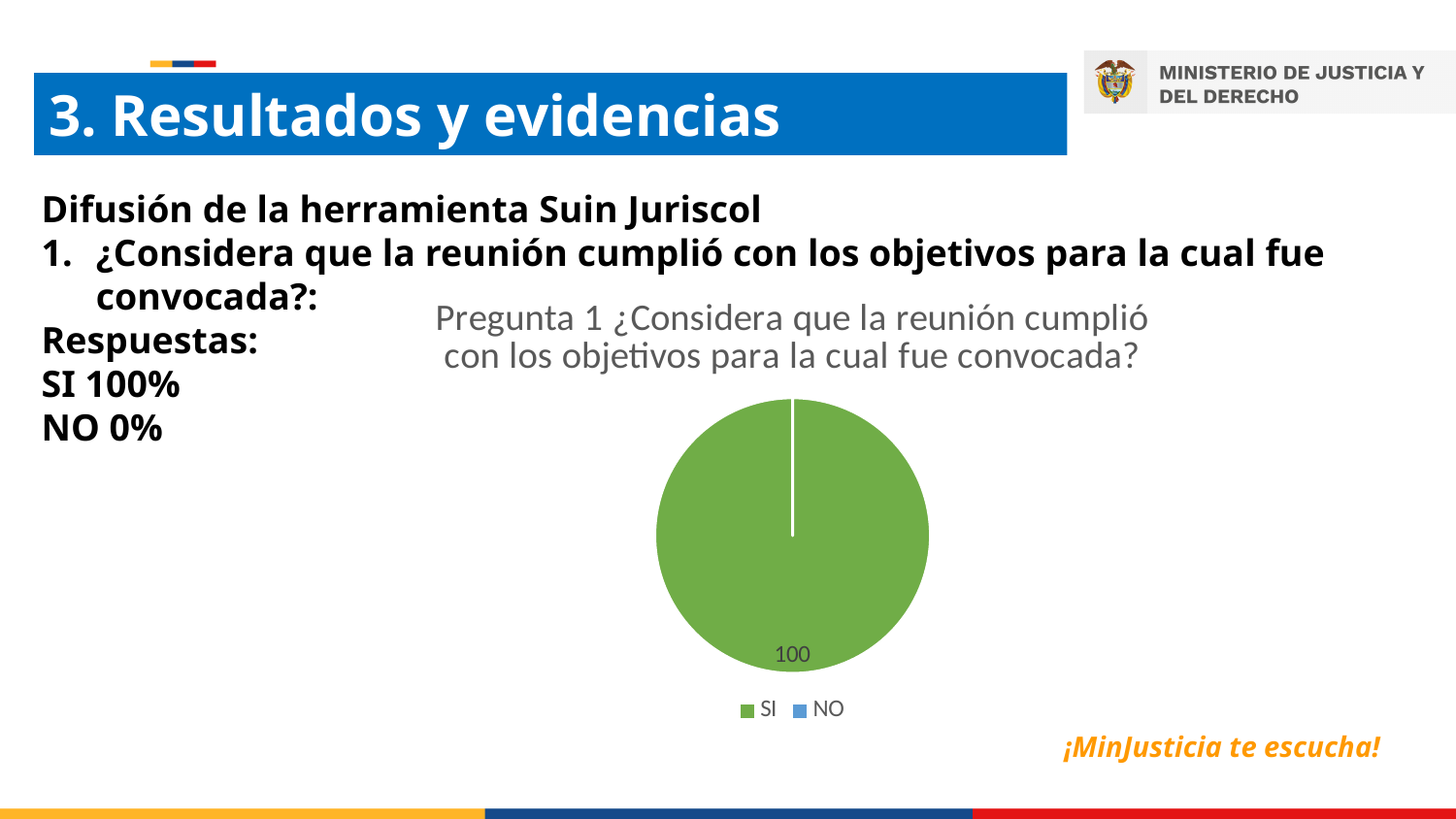
What is the data label shown on the SI slice of the pie chart? 100 How many series does the legend of the pie chart list? 2 What kind of chart is shown on the slide? pie chart What is the title of the pie chart? Pregunta 1 ¿Considera que la reunión cumplió con los objetivos para la cual fue convocada? Which is larger in the pie chart, SI or NO? SI What share of the pie does the SI slice take up? 100% What colour is the SI slice in the pie chart? green Is the value for SI in the pie chart greater or less than 50? greater Which category has the largest slice in the pie chart? SI Which category has the smallest share in the pie chart? NO